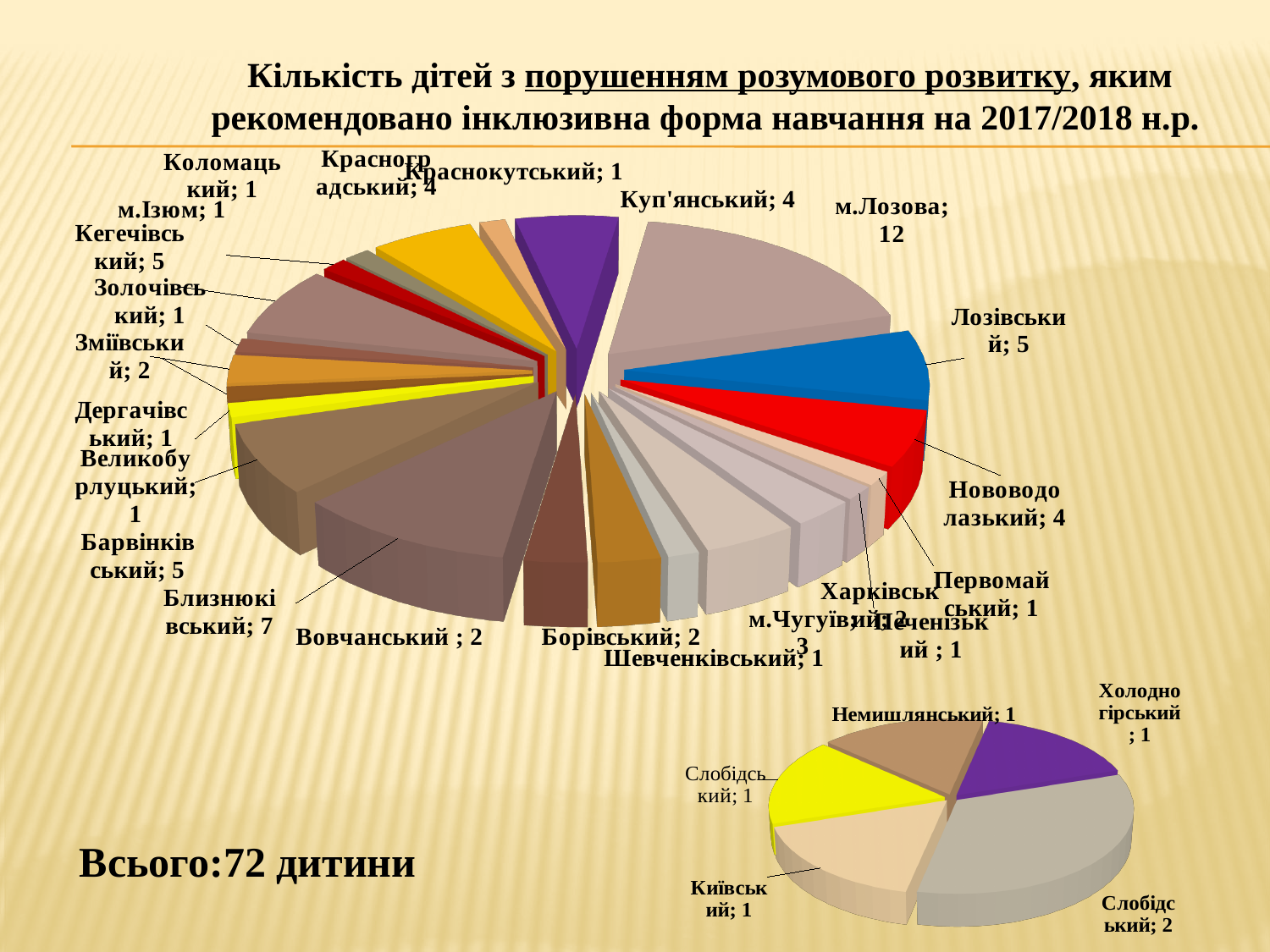
In the small pie chart at the bottom right, what is the value for Немишлянський? 1 In the large pie chart, which category has the highest value? м.Лозова In the large pie chart, what is the value for м.Чугуїв? 3 In the large pie chart, what is the value for Кегечівський? 5 What total number of children is stated on the slide? 72 дитини In the large pie chart, what is the difference between the values for м.Лозова and Близнюківський? 5 What kind of chart is the large chart on the slide? pie chart In the small pie chart at the bottom right, how many slices are there? 5 In the large pie chart, what is the value for Близнюківський? 7 In the large pie chart, how many children are shown for м.Лозова? 12 In the large pie chart, which is larger: Кегечівський or Куп'янський? Кегечівський In the small pie chart at the bottom right, what is the value for Київський? 1